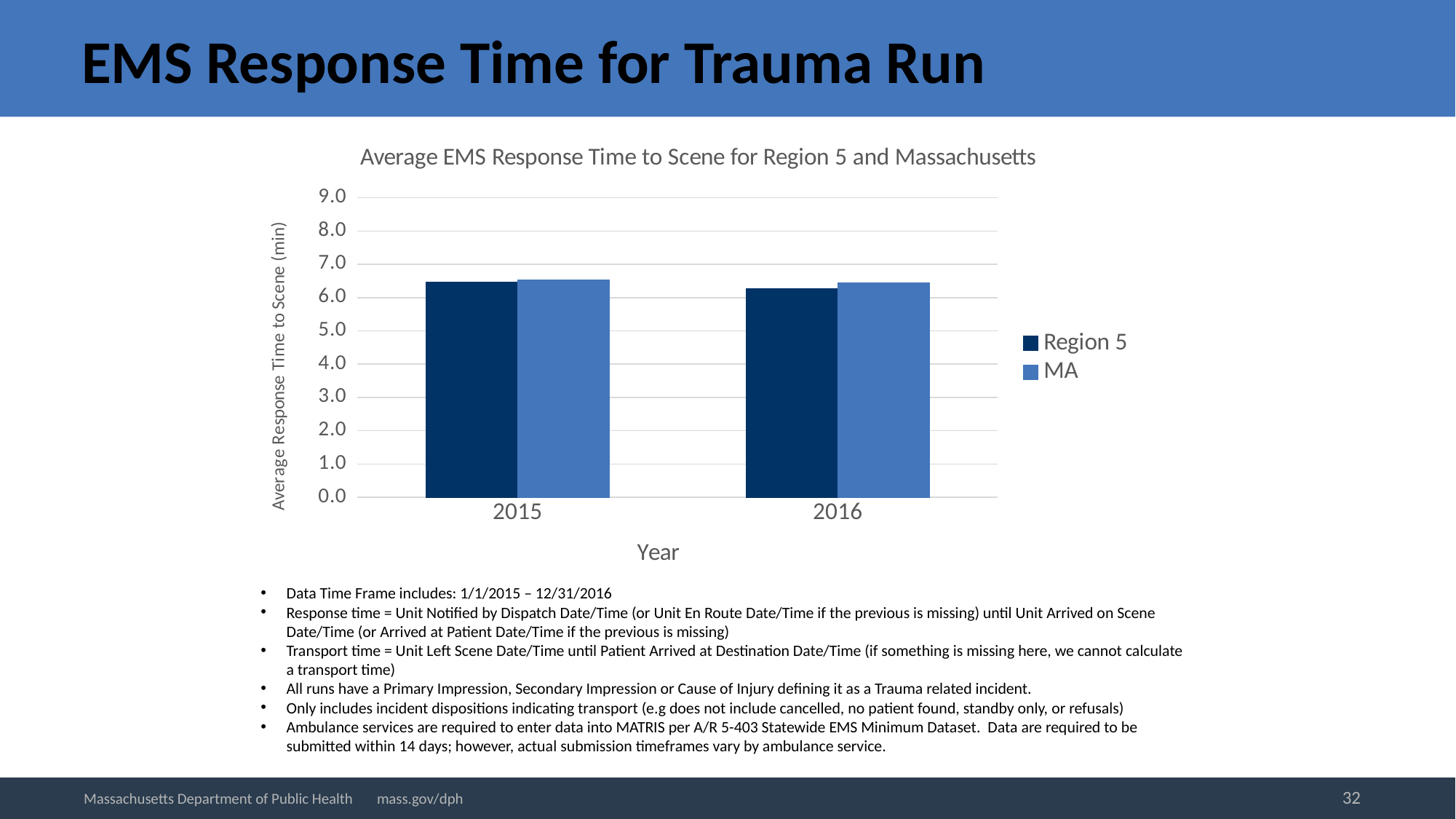
What is the title of the chart? Average EMS Response Time to Scene for Region 5 and Massachusetts How many years are shown on the x axis? 2 Is the value for Region 5 in 2015 greater or less than 6.0? greater Which series are listed in the legend? Region 5 and MA Is the value for Region 5 in 2016 greater or less than 7.0? less Is the value for MA in 2015 greater or less than 7.0? less How many series does the legend list? 2 What is the label of the y axis? Average Response Time to Scene (min) What kind of chart is shown on the slide? bar chart Does the Region 5 value rise or fall from 2015 to 2016? fall